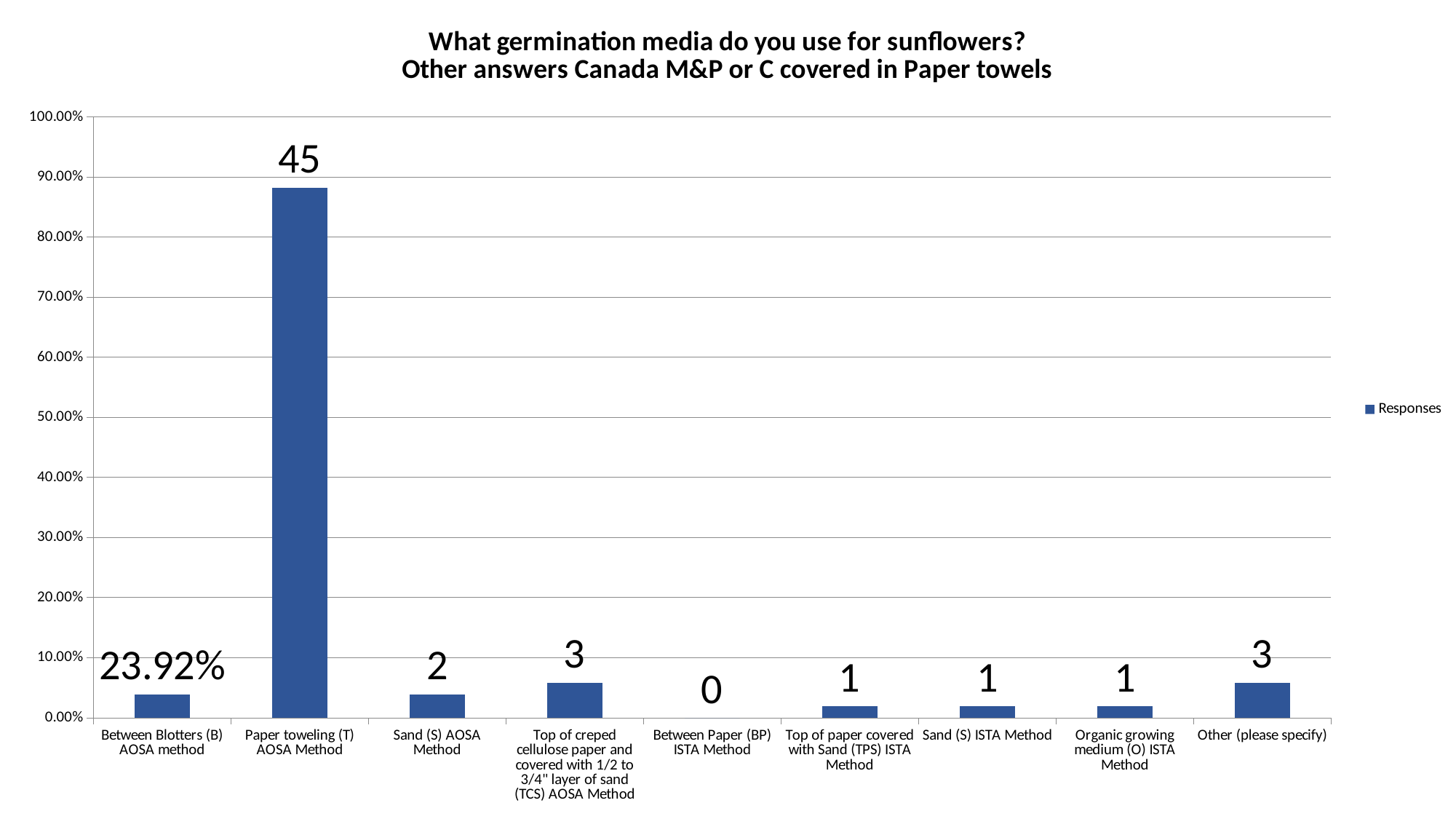
Which is larger, the value for Sand (S) AOSA Method or Sand (S) ISTA Method? Sand (S) AOSA Method Which category has the highest value? Paper toweling (T) AOSA Method Is the bar for Paper toweling (T) AOSA Method greater or less than 80.00% on the axis? greater What is the data label for Between Paper (BP) ISTA Method? 0 Which category has the lowest value? Between Paper (BP) ISTA Method How many categories are shown on the x axis? 9 What is the data label for Sand (S) AOSA Method? 2 What kind of chart is shown on the slide? bar chart What is the data label for Other (please specify)? 3 What is the data label for Paper toweling (T) AOSA Method? 45 What is the difference between the data labels for Paper toweling (T) AOSA Method and Other (please specify)? 42 How many series does the legend list? 1